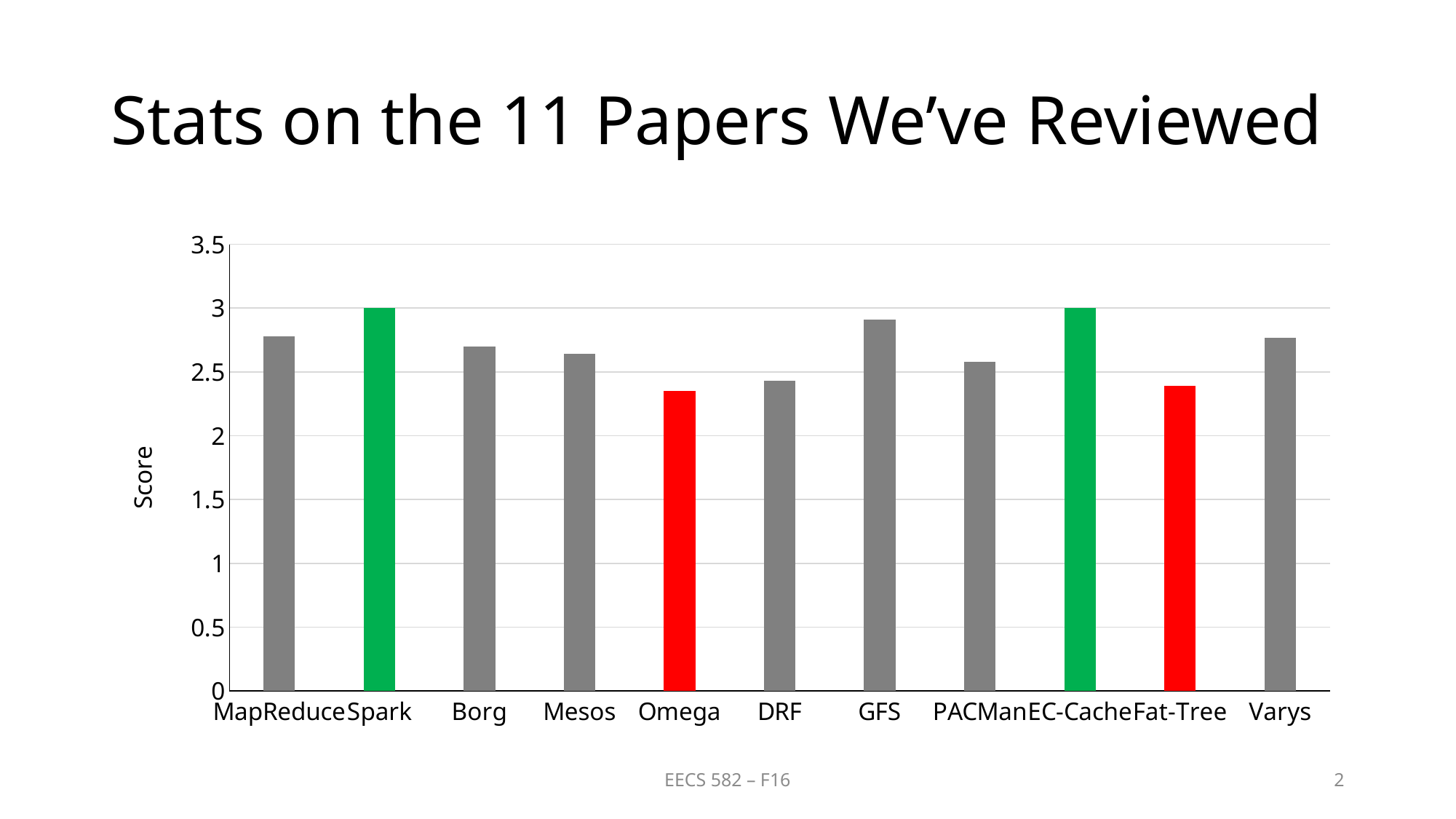
What is the score for EC-Cache? 3 Which two papers have red bars on the chart? Omega and Fat-Tree What is the label on the vertical axis of the chart? Score Which has the higher score, GFS or Omega? GFS Is the value for Fat-Tree greater or less than 2.5? less What kind of chart is shown on the slide? bar chart Is the value for GFS greater or less than 2.5? greater Is the value for DRF greater or less than 2.5? less What is the score for Spark? 3 How many papers (categories) are plotted on the chart? 11